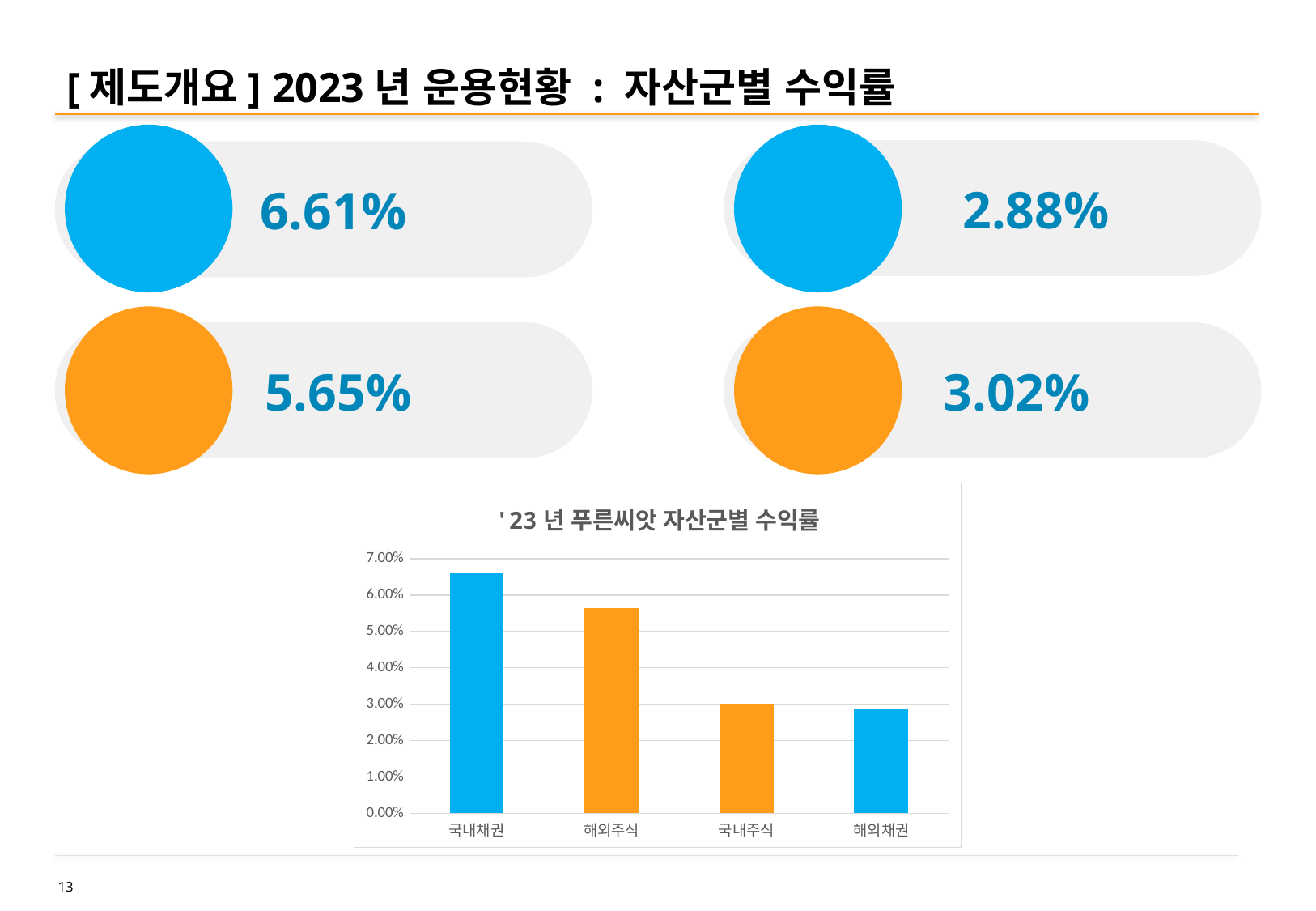
What colour is the bar for 해외주식? orange How many categories are shown on the x axis of the chart? 4 What is the title of the chart? '23 년 푸른씨앗 자산군별 수익률 Do the bar values rise or fall from left to right along the x axis? fall What kind of chart is shown on the slide? bar chart Is the value for 국내채권 greater or less than 6.00%? greater Which category has the lowest bar in the chart? 해외채권 Is the value for 해외주식 greater or less than 6.00%? less Which is larger, the value for 해외주식 or the value for 국내주식? 해외주식 Which category has the highest bar in the chart? 국내채권 Is the value for 국내주식 greater or less than 4.00%? less